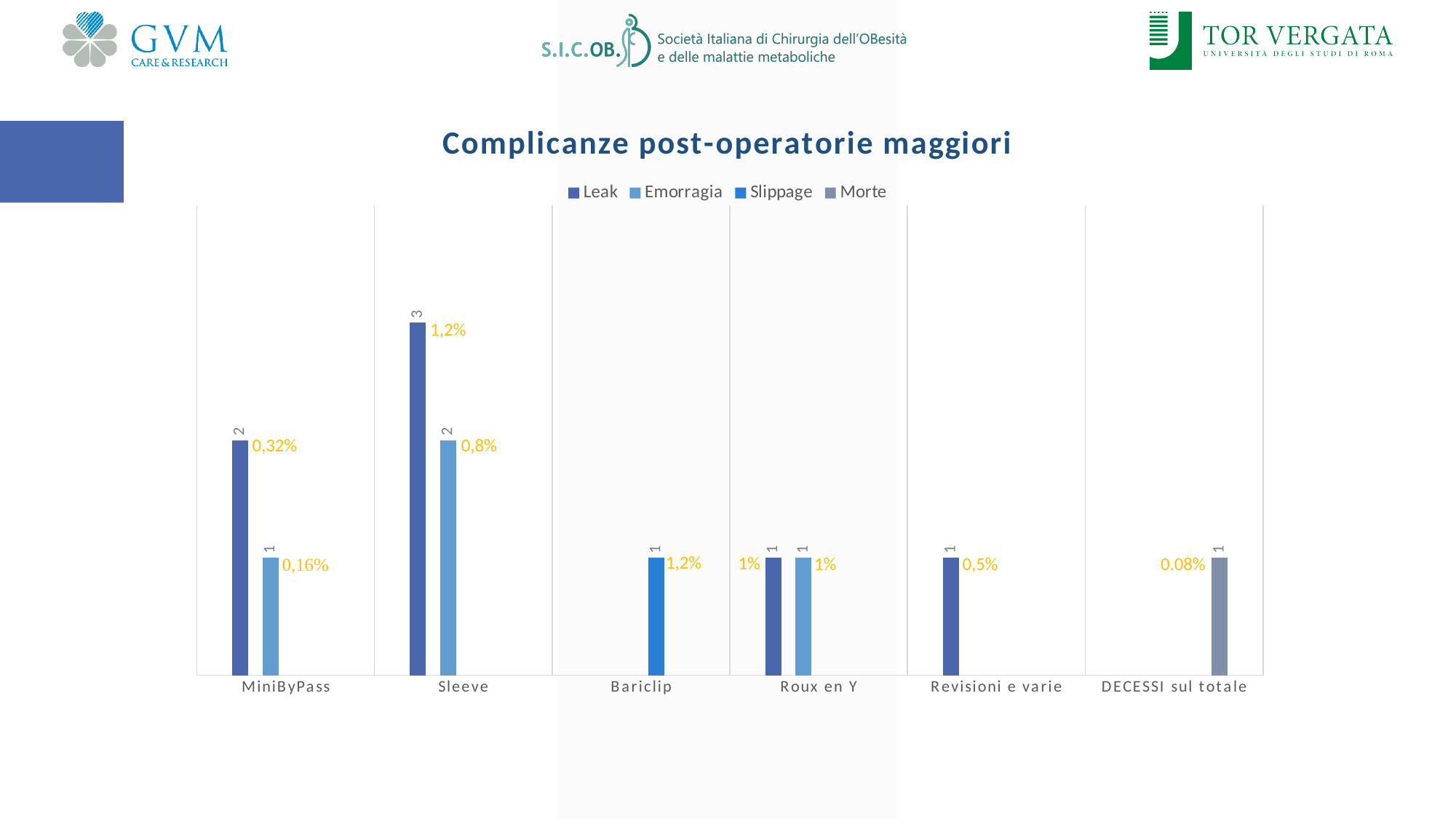
What is the title of the chart? Complicanze post-operatorie maggiori Which series is the only one plotted for Bariclip? Slippage Which category has the highest Leak count? Sleeve Which is larger for MiniByPass, the Leak count or the Emorragia count? Leak How many categories are shown on the x axis? 6 What is the difference between the Leak count and the Emorragia count for Sleeve? 1 What percentage is shown next to the Emorragia bar for Sleeve? 0,8% What percentage is shown for the Morte bar in DECESSI sul totale? 0.08% What percentage is shown next to the Leak bar for MiniByPass? 0,32% What type of chart is shown on the slide? bar chart How many series does the legend list? 4 What is the Leak count for Sleeve? 3